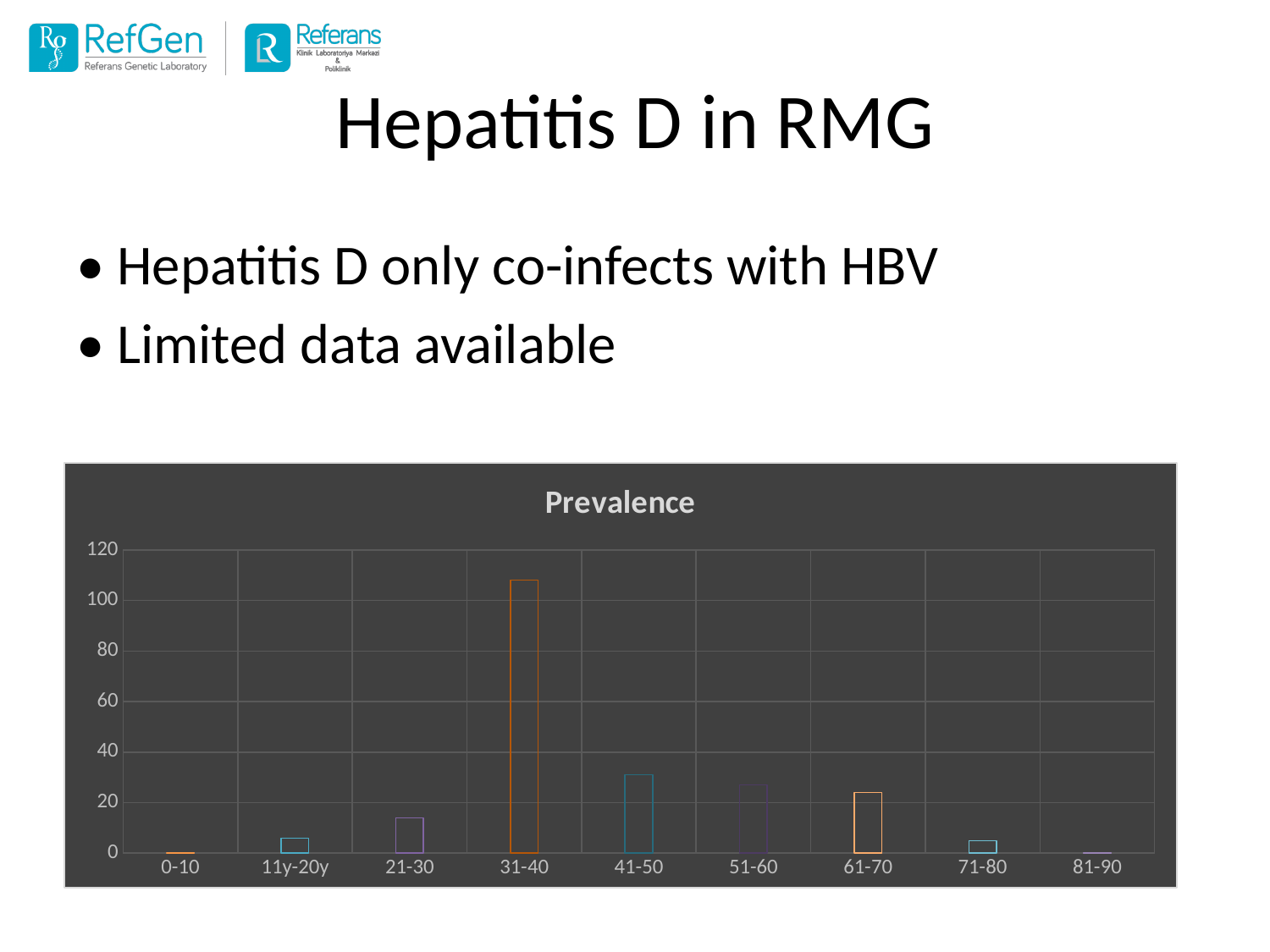
What kind of chart is shown on the slide? bar chart Is the value for 41-50 greater or less than 40? less What is the highest value shown on the y axis of the chart? 120 What is the title of the chart? Prevalence Is the value for 21-30 greater or less than 20? less Is the value for 61-70 greater or less than 20? greater Which is larger, the value for 31-40 or the value for 41-50? 31-40 Which is larger, the value for 21-30 or the value for 61-70? 61-70 How many age-group categories are shown on the x axis of the chart? 9 Which is larger, the value for 11y-20y or the value for 41-50? 41-50 Which age group has the highest prevalence in the chart? 31-40